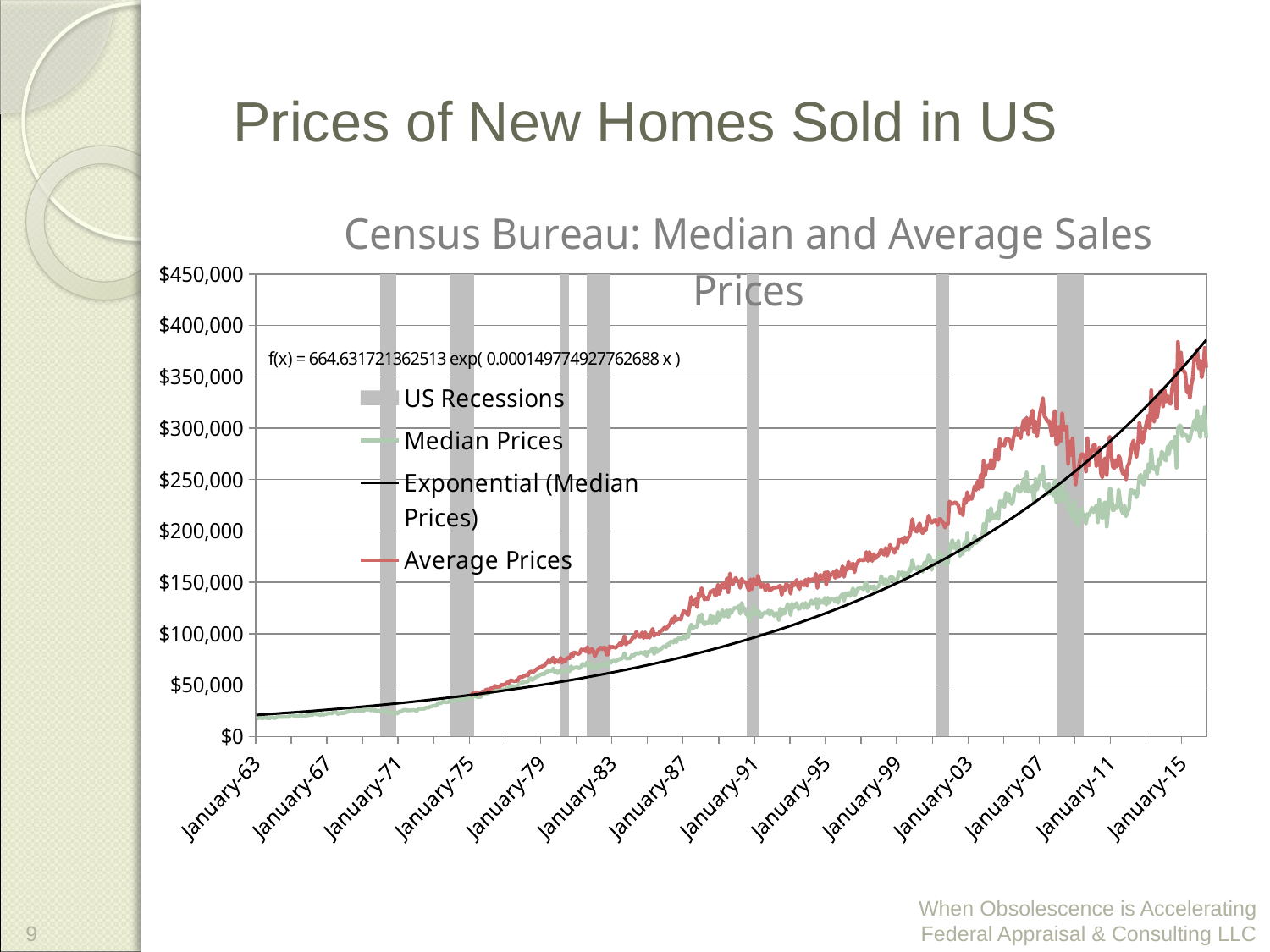
What kind of chart is shown on the slide? line chart How many entries does the chart's legend list? 4 At January-07, which is higher: Average Prices or Median Prices? Average Prices Is the value for Median Prices at January-99 greater or less than $200,000? less How many date labels are shown on the x axis? 14 Is the value for Median Prices at January-63 greater or less than $50,000? less Is the value for Average Prices at January-15 greater or less than $300,000? greater Which legend entry is drawn in red? Average Prices How many shaded US Recessions bands are shown on the chart? 7 What is the title of the chart? Census Bureau: Median and Average Sales Prices Do Median Prices generally rise or fall from January-63 to January-15? rise